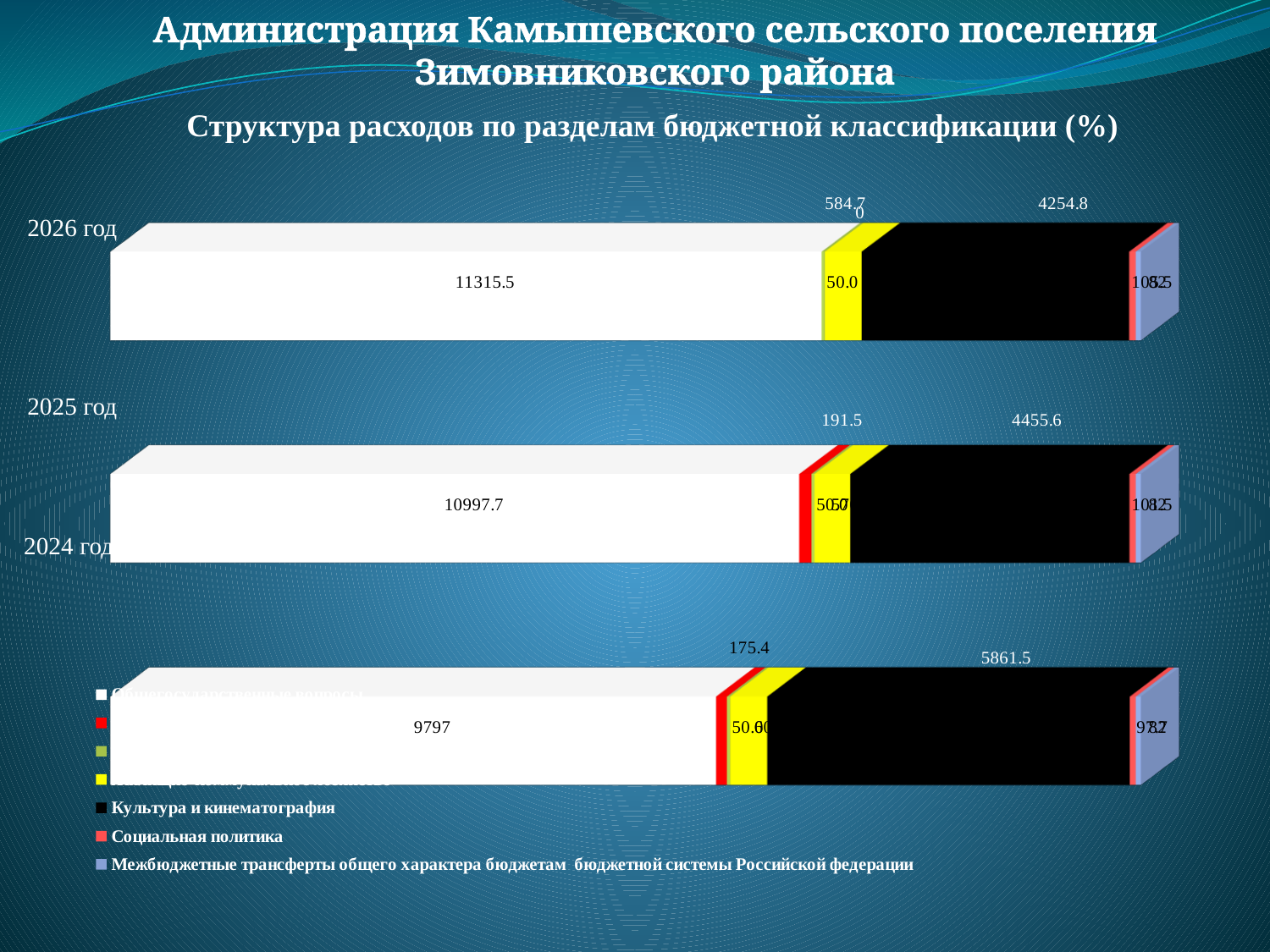
What kind of chart is shown on the slide? bar chart What is the value of the Культура и кинематография segment for 2026 год? 4254.8 In which year is the Культура и кинематография segment the smallest? 2026 год What is the value of the Культура и кинематография segment for 2025 год? 4455.6 What is the value of the largest (white) segment of the 2025 год bar? 10997.7 What is the value of the Культура и кинематография segment for 2024 год? 5861.5 What is the difference between the Культура и кинематография values for 2024 год and 2026 год? 1606.7 In which year is the Культура и кинематография segment the largest? 2024 год Which year has the larger white segment, 2026 год or 2024 год? 2026 год How many years (bars) are shown in the chart? 3 What is the title of the chart? Структура расходов по разделам бюджетной классификации (%) What is the difference between the white segment values for 2026 год and 2025 год? 317.8